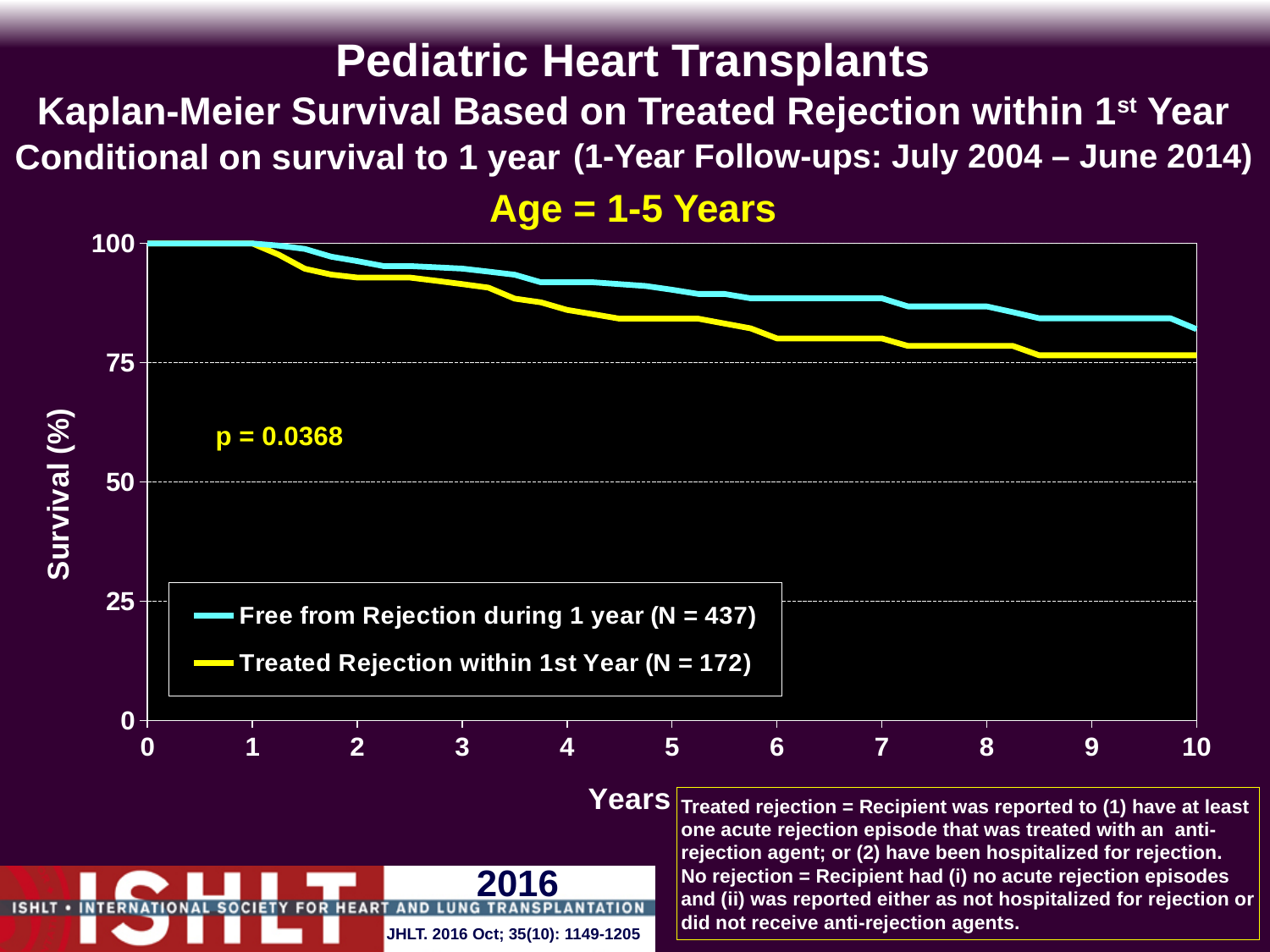
Is the survival value for the Treated Rejection within 1st Year group at 3 years greater or less than 75? greater At 5 years, which group has higher survival: Free from Rejection during 1 year or Treated Rejection within 1st Year? Free from Rejection during 1 year What is the survival (%) for both groups at 0 years? 100 Do the survival curves rise or fall as years increase? Fall What kind of chart is shown on the slide? Line chart What is the p-value shown on the chart? p = 0.0368 How many series does the legend list? 2 What is the N for the 'Free from Rejection during 1 year' group? 437 Is the survival value for the Treated Rejection within 1st Year group at 5 years greater or less than 75? greater Is the survival value for the Free from Rejection during 1 year group at 10 years greater or less than 75? greater What is the maximum value shown on the x axis (Years)? 10 What is the N for the 'Treated Rejection within 1st Year' group? 172